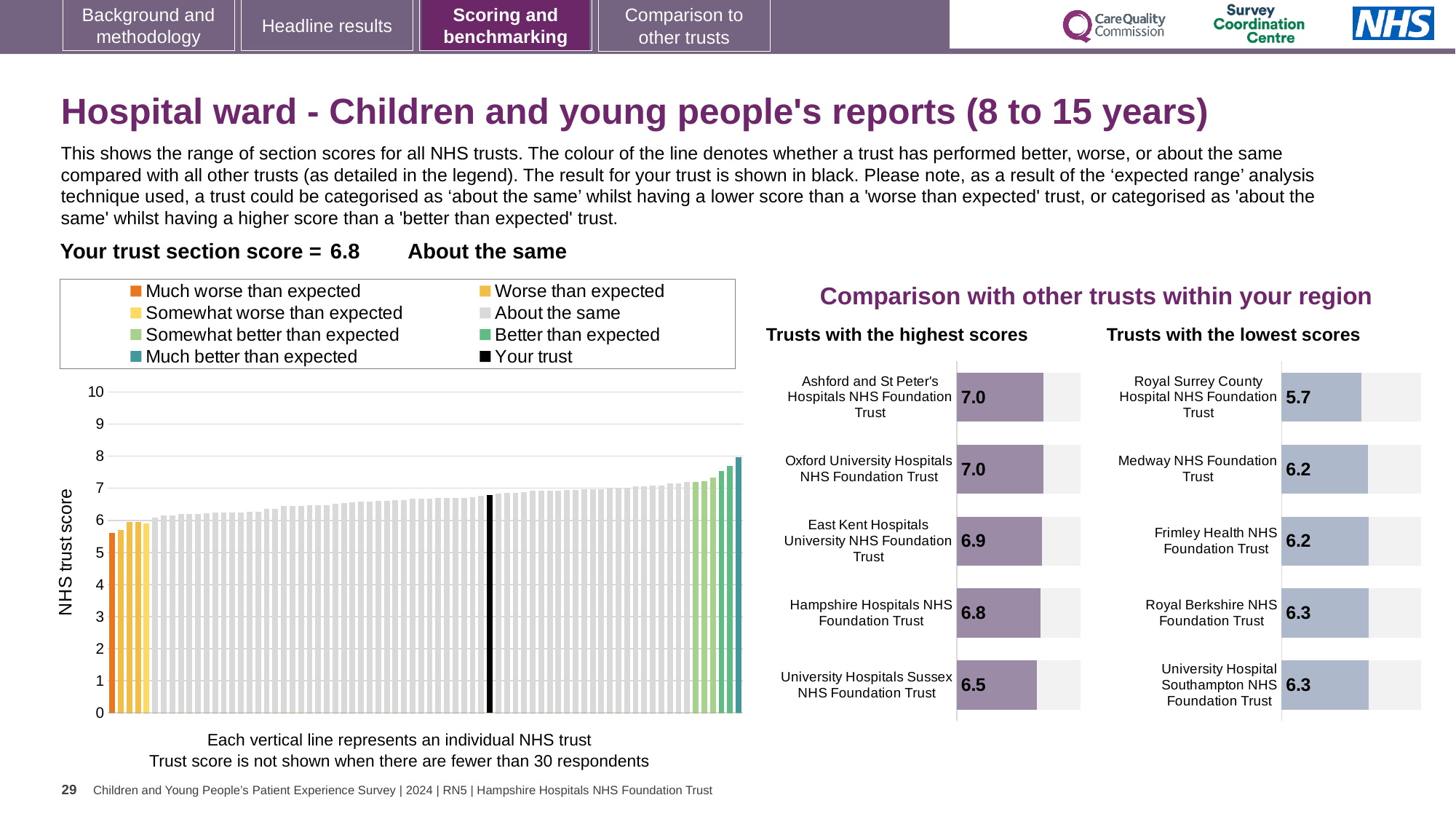
In the 'NHS trust score' chart, is the value of the black 'Your trust' bar greater or less than 6? greater In the 'Trusts with the highest scores' chart, which trust has the lowest score? University Hospitals Sussex NHS Foundation Trust In the 'NHS trust score' chart, is the value of the leftmost (orange) bar greater or less than 6? less In the 'NHS trust score' chart, is the value of the rightmost bar greater or less than 7? greater In the 'Trusts with the highest scores' chart, what is the difference between the scores of Ashford and St Peter's Hospitals NHS Foundation Trust and University Hospitals Sussex NHS Foundation Trust? 0.5 In the 'Trusts with the highest scores' chart, what is the score for East Kent Hospitals University NHS Foundation Trust? 6.9 In the 'Trusts with the lowest scores' chart, what is the score for Medway NHS Foundation Trust? 6.2 What kind of chart is the large chart on the left with the y axis labelled 'NHS trust score'? bar chart In the 'Trusts with the lowest scores' chart, which trust has the lowest score? Royal Surrey County Hospital NHS Foundation Trust In the 'NHS trust score' chart, do the bars rise or fall from left to right? rise How many entries does the legend above the 'NHS trust score' chart list? 8 How many trusts are shown in the 'Trusts with the lowest scores' chart? 5